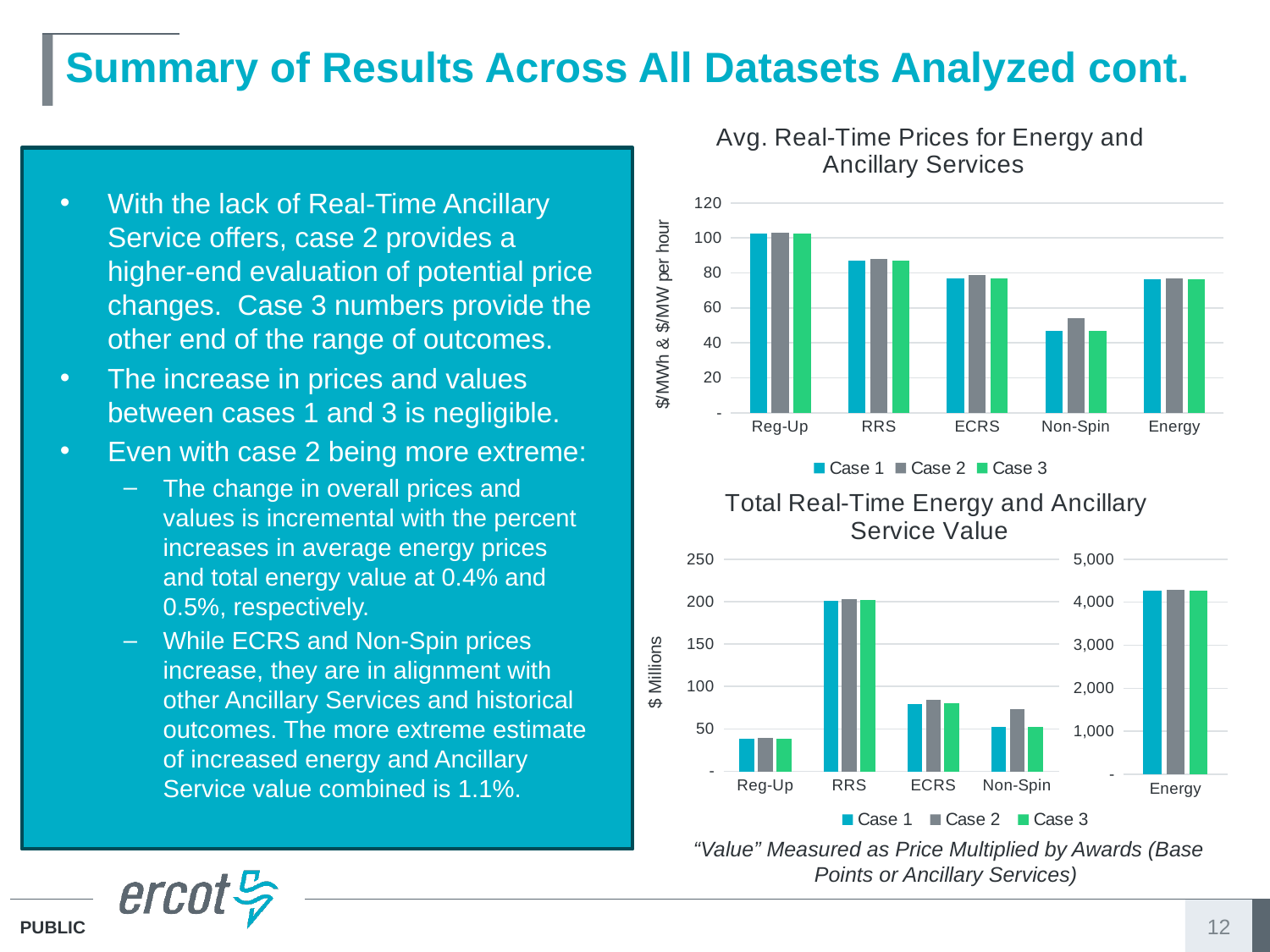
How many categories are shown on the x axis of the 'Avg. Real-Time Prices for Energy and Ancillary Services' chart? 5 In the 'Total Real-Time Energy and Ancillary Service Value' chart, is the Case 1 value for RRS greater or less than 150? greater What kind of chart is the 'Avg. Real-Time Prices for Energy and Ancillary Services' chart? Bar chart In the 'Avg. Real-Time Prices for Energy and Ancillary Services' chart, which category has the lowest prices? Non-Spin What is the y-axis label of the 'Avg. Real-Time Prices for Energy and Ancillary Services' chart? $/MWh & $/MW per hour In the 'Avg. Real-Time Prices for Energy and Ancillary Services' chart, which category has the highest prices? Reg-Up In the 'Avg. Real-Time Prices for Energy and Ancillary Services' chart, is the Case 1 value for Non-Spin greater or less than 40? greater How many series does the legend of the 'Avg. Real-Time Prices for Energy and Ancillary Services' chart list? 3 In the 'Total Real-Time Energy and Ancillary Service Value' chart, is the Case 1 value for Energy greater or less than 4,000 on the right-hand axis? greater In the 'Total Real-Time Energy and Ancillary Service Value' chart, which category has the lowest values? Reg-Up In the 'Avg. Real-Time Prices for Energy and Ancillary Services' chart, which is larger for Non-Spin: Case 1 or Case 2? Case 2